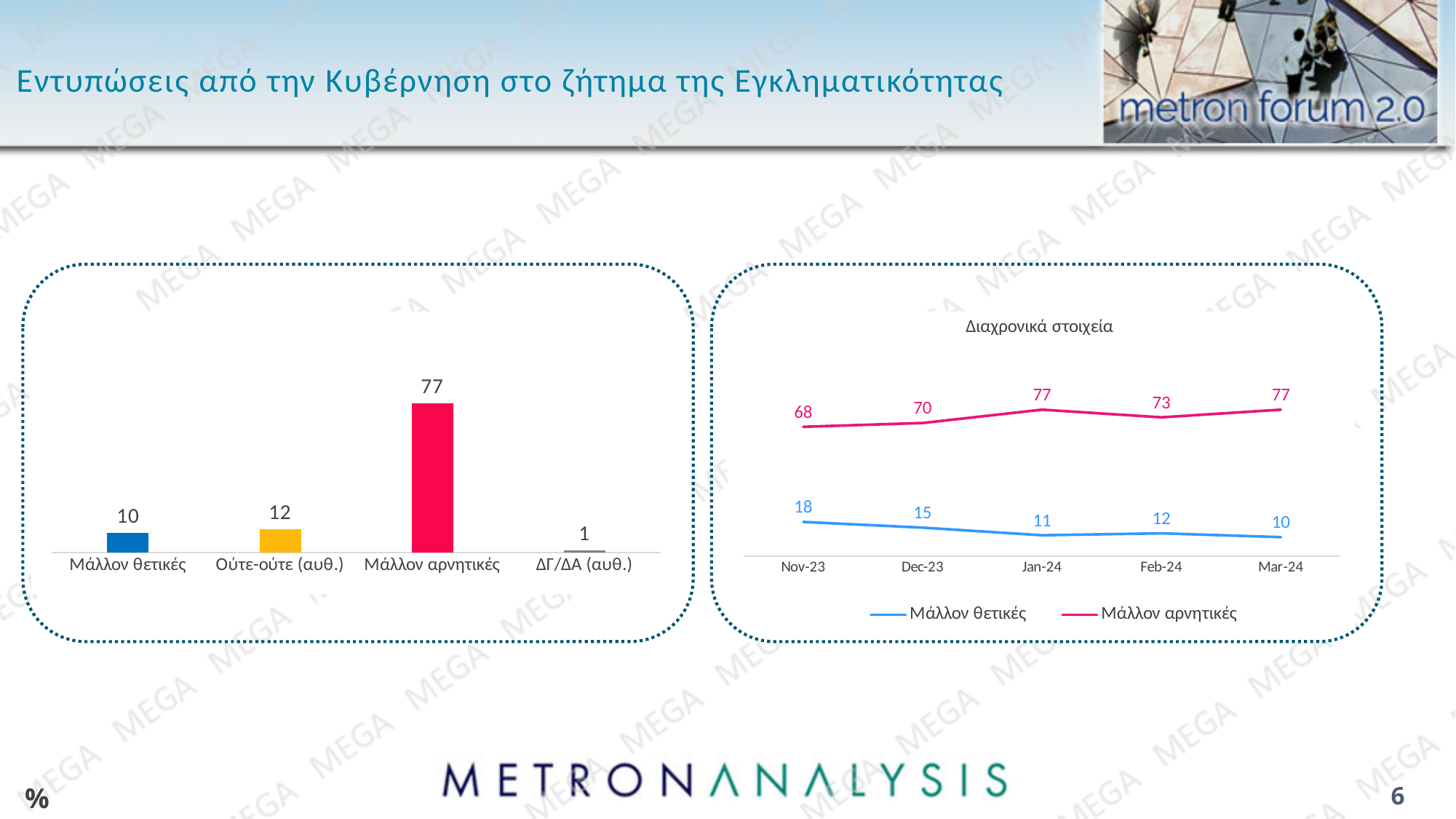
In the 'Διαχρονικά στοιχεία' chart, what is the difference between Μάλλον αρνητικές and Μάλλον θετικές in Mar-24? 67 In the 'Διαχρονικά στοιχεία' chart, does the Μάλλον θετικές series rise or fall from Nov-23 to Mar-24? fall In the 'Διαχρονικά στοιχεία' chart, what is the value for Μάλλον θετικές in Nov-23? 18 In the 'Διαχρονικά στοιχεία' chart, what is the value for Μάλλον αρνητικές in Feb-24? 73 In the bar chart on the left, how many categories are shown? 4 What kind of chart is the chart on the left? bar chart In the 'Διαχρονικά στοιχεία' chart, how many series does the legend list? 2 In the bar chart on the left, what is the value for Ούτε-ούτε (αυθ.)? 12 In the bar chart on the left, what is the value for Μάλλον αρνητικές? 77 In the bar chart on the left, which category has the highest value? Μάλλον αρνητικές In the bar chart on the left, which category has the lowest value? ΔΓ/ΔΑ (αυθ.) In the bar chart on the left, what is the difference between Μάλλον αρνητικές and Μάλλον θετικές? 67